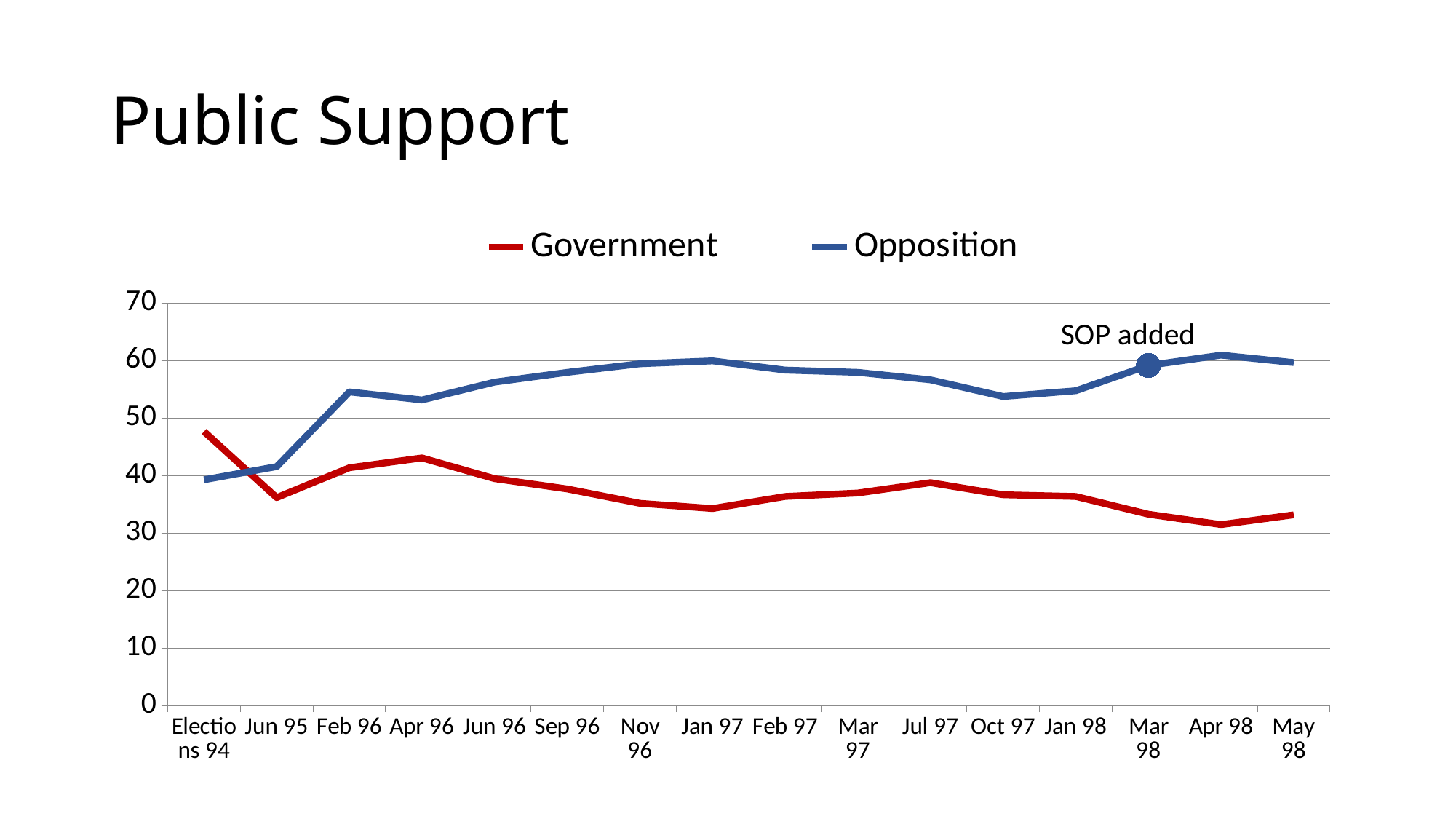
At which category does the Government series reach its highest value? Elections 94 What is the title of the slide? Public Support Is the Government value at Apr 98 greater or less than 40? less What annotation is written next to the marked point on the Opposition line at Mar 98? SOP added At May 98, which series has the higher value, Government or Opposition? Opposition At Elections 94, which series has the higher value, Government or Opposition? Government Is the Government value at Elections 94 greater or less than 40? greater What kind of chart is shown on the slide? line chart Is the Opposition value at Jan 97 greater or less than 50? greater How many categories are shown along the x axis? 16 How many series does the legend list? 2